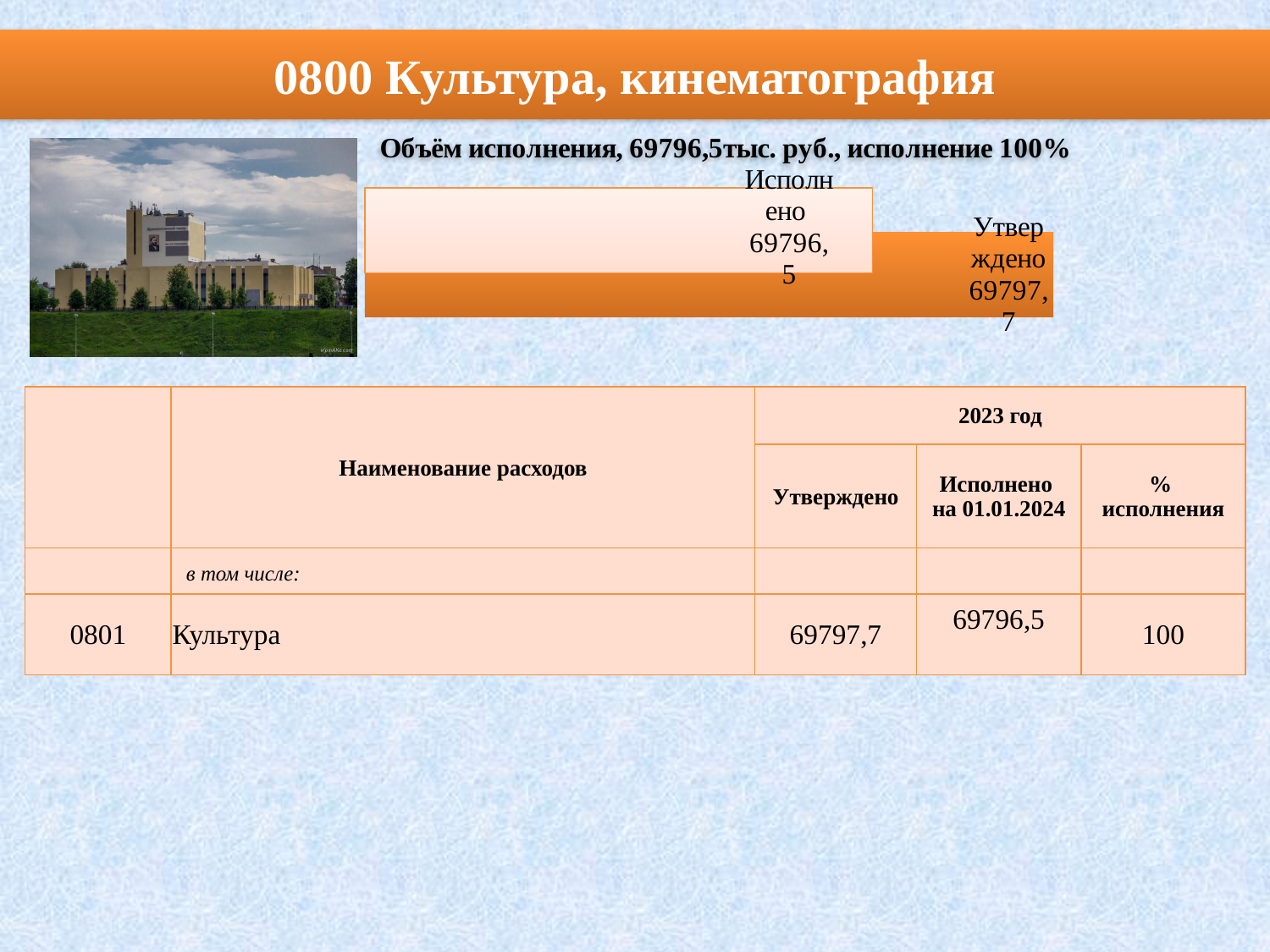
Which bar has the larger value, "Утверждено" or "Исполнено"? Утверждено What is the value of the bar labelled "Утверждено"? 69797,7 How many bars does the chart show? 2 What is the value of the bar labelled "Исполнено"? 69796,5 What is the difference between the "Утверждено" value and the "Исполнено" value? 1,2 What colour is the "Утверждено" bar? orange Which bar has the lowest value? Исполнено Which bar has the highest value? Утверждено What is the title of the slide above the chart? 0800 Культура, кинематография What kind of chart is shown on the slide? bar chart